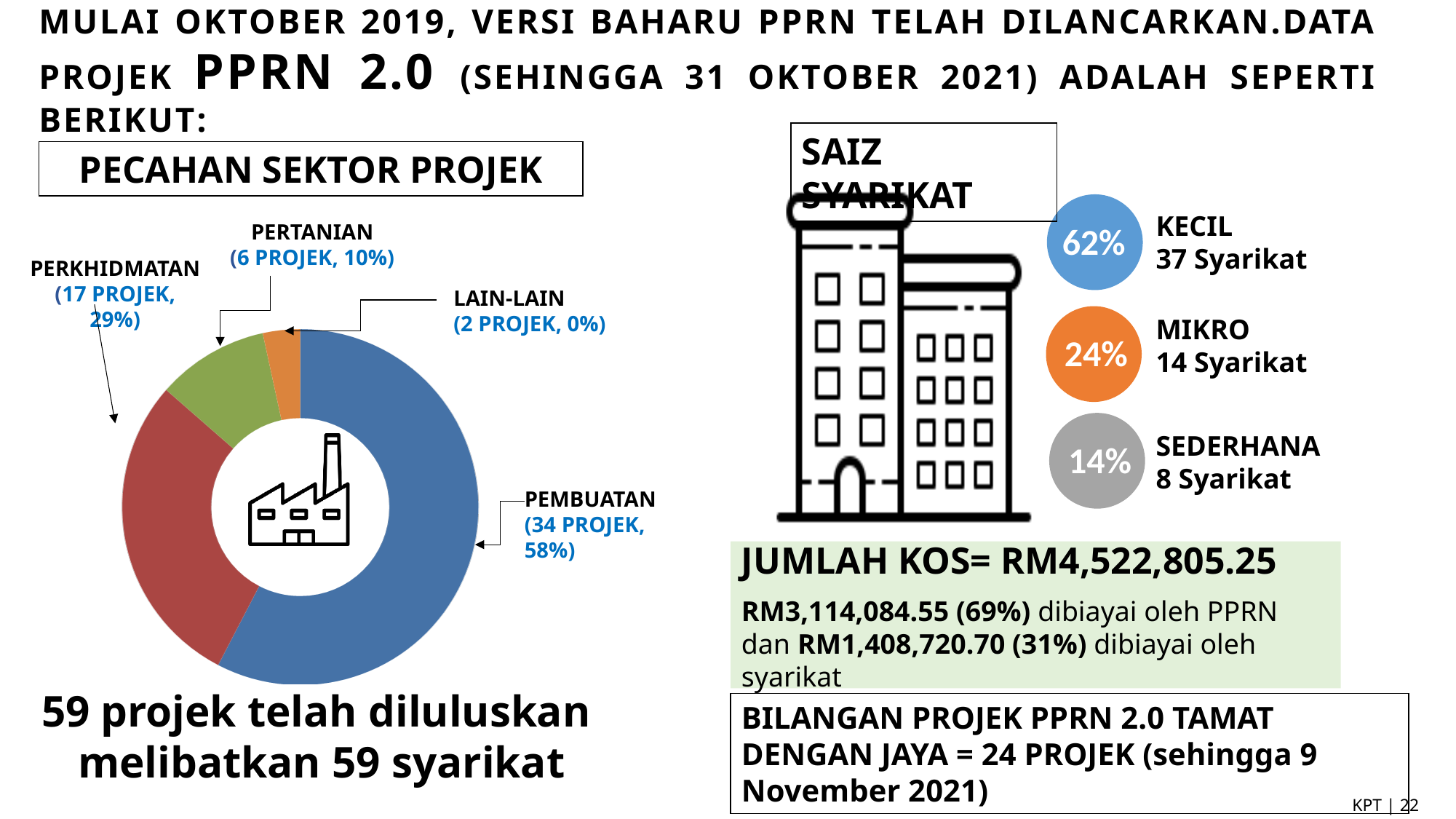
In the PECAHAN SEKTOR PROJEK chart, which sector has the most projects? PEMBUATAN In the PECAHAN SEKTOR PROJEK chart, how many projects are in the PERKHIDMATAN sector? 17 In the PECAHAN SEKTOR PROJEK chart, what share of projects does PERKHIDMATAN account for? 29% In the PECAHAN SEKTOR PROJEK chart, what colour is the PEMBUATAN slice? Blue In the PECAHAN SEKTOR PROJEK chart, which has more projects, PERTANIAN or LAIN-LAIN? PERTANIAN In the PECAHAN SEKTOR PROJEK chart, what is the total number of projects across all sectors? 59 What kind of chart is the PECAHAN SEKTOR PROJEK chart? Doughnut chart In the PECAHAN SEKTOR PROJEK chart, which sector has the fewest projects? LAIN-LAIN In the PECAHAN SEKTOR PROJEK chart, how many projects are in the PEMBUATAN sector? 34 In the PECAHAN SEKTOR PROJEK chart, what share of projects does PERTANIAN account for? 10% How many sectors are shown in the PECAHAN SEKTOR PROJEK chart? 4 In the PECAHAN SEKTOR PROJEK chart, how many more projects does PEMBUATAN have than PERKHIDMATAN? 17